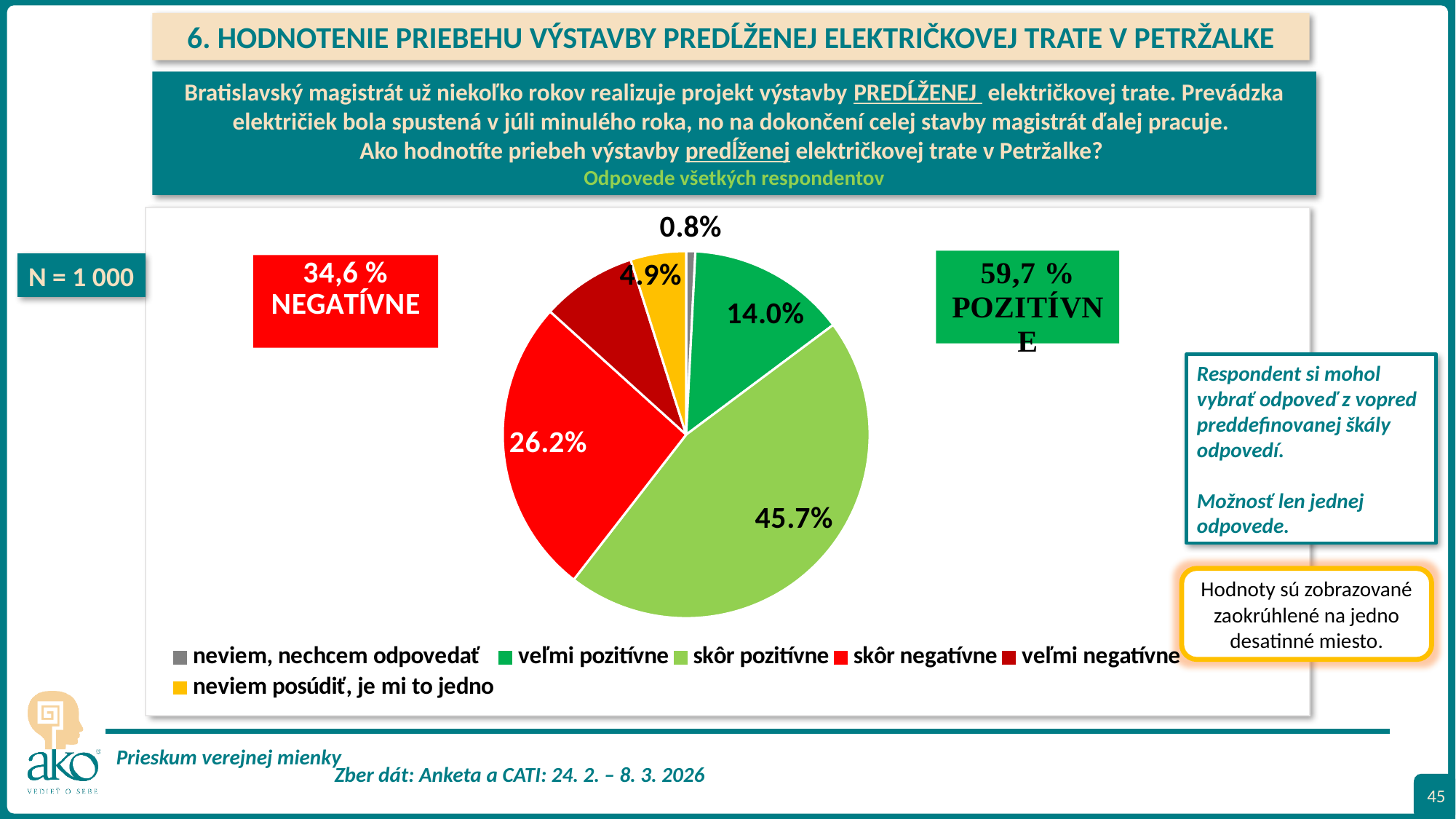
Which is larger: the share for "veľmi pozitívne" or the share for "skôr negatívne"? skôr negatívne What colour is the slice for "neviem posúdiť, je mi to jedno"? yellow What share of respondents answered "neviem, nechcem odpovedať"? 0.8% What share of respondents answered "veľmi pozitívne"? 14.0% What is the difference in percentage points between "skôr pozitívne" and "skôr negatívne"? 19.5 What share of respondents answered "skôr negatívne"? 26.2% What share of respondents answered "neviem posúdiť, je mi to jedno"? 4.9% Which answer category has the largest slice of the pie? skôr pozitívne Which answer category has the smallest slice of the pie? neviem, nechcem odpovedať What type of chart is shown on the slide? pie chart What share of respondents answered "skôr pozitívne"? 45.7% How many answer categories does the legend list? 6